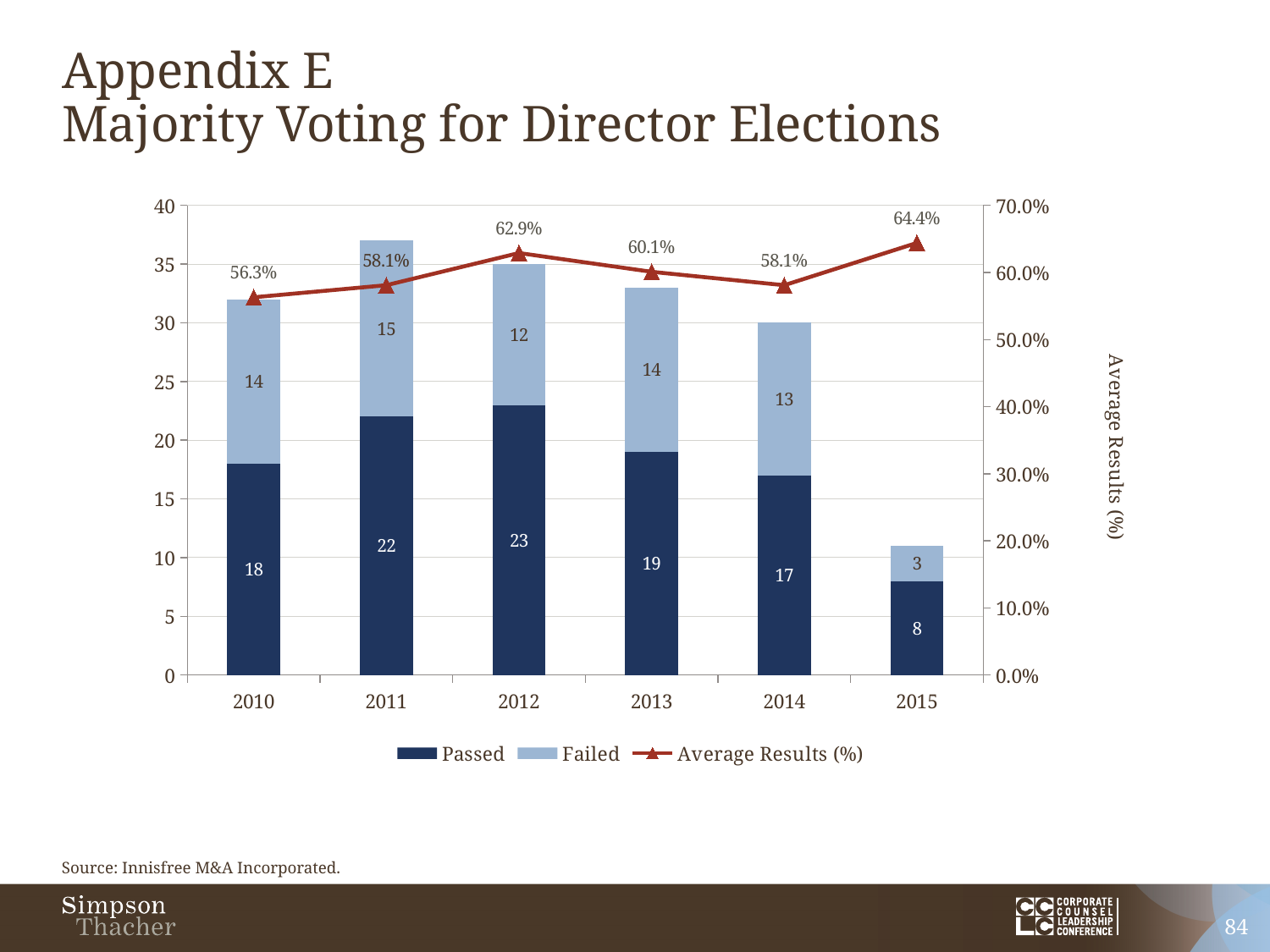
What kind of chart is shown on the slide? Stacked bar chart with a line Which year has the lowest number of Failed proposals? 2015 What is the difference between Passed proposals in 2011 and 2015? 14 What is the number of Failed proposals in 2011? 15 How many series does the legend list? 3 Which is larger, the number of Failed proposals in 2013 or in 2014? 2013 What is the label of the right-hand vertical axis? Average Results (%) Which year has the highest number of Passed proposals? 2012 What is the number of Passed proposals in 2012? 23 What is the total of the stacked bar for 2010 (Passed plus Failed)? 32 What is the Average Results (%) value for 2015? 64.4% How many years are shown on the x axis? 6